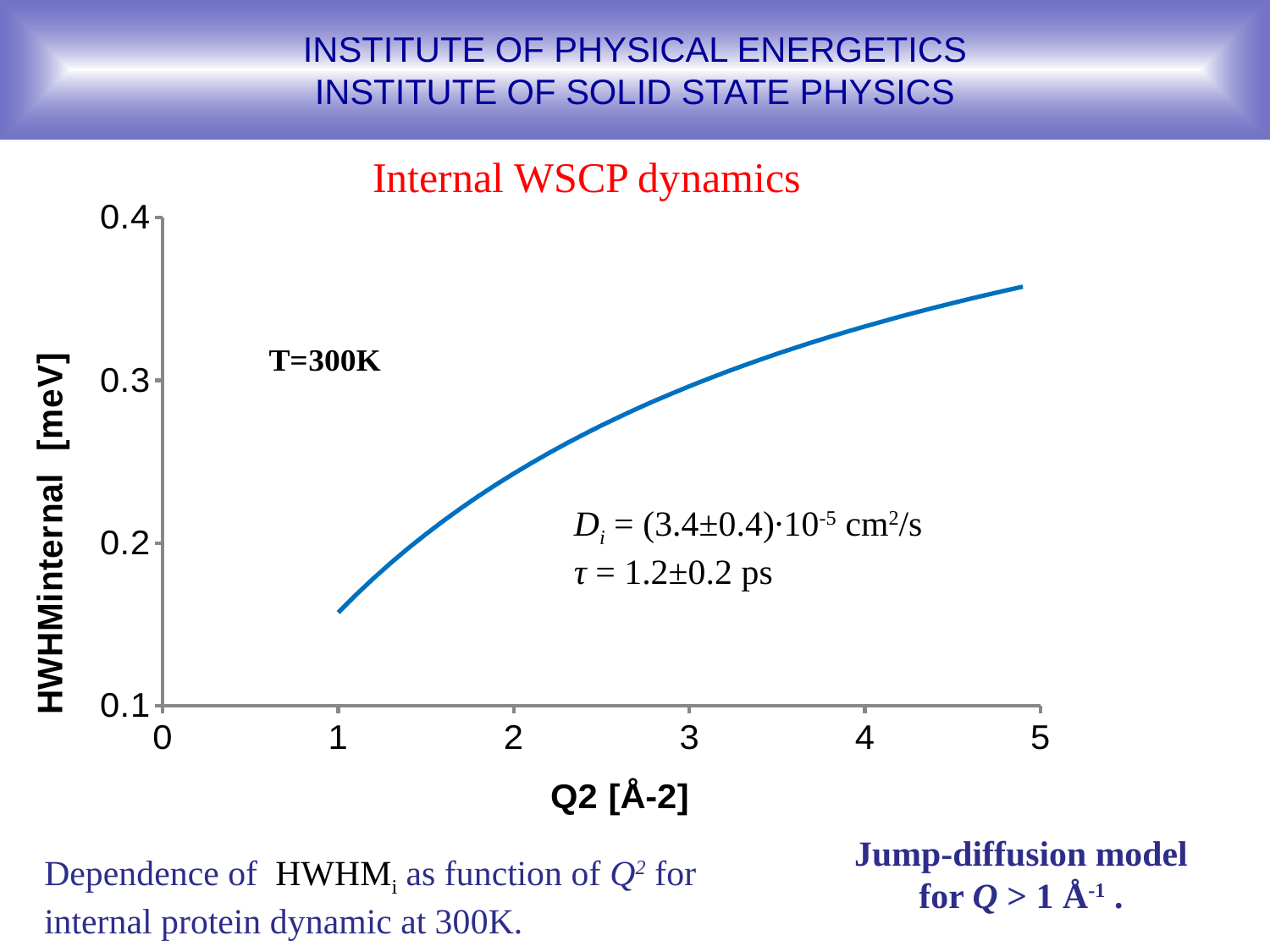
What is the title of the chart? Internal WSCP dynamics What kind of chart is shown on the slide? line chart What is the label of the x axis? Q2 [Å-2] What is the label of the y axis? HWHMinternal [meV] How many curves (series) are plotted on the chart? 1 Is the value of HWHMinternal at Q2 = 2 greater or less than 0.2 meV? greater Is the highest value reached by the curve greater or less than 0.4 meV? less Is the value of HWHMinternal at Q2 = 1 greater or less than 0.2 meV? less Which is larger, the HWHMinternal value at Q2 = 4 or at Q2 = 2? Q2 = 4 Does HWHMinternal rise or fall as Q2 increases along the x axis? rise